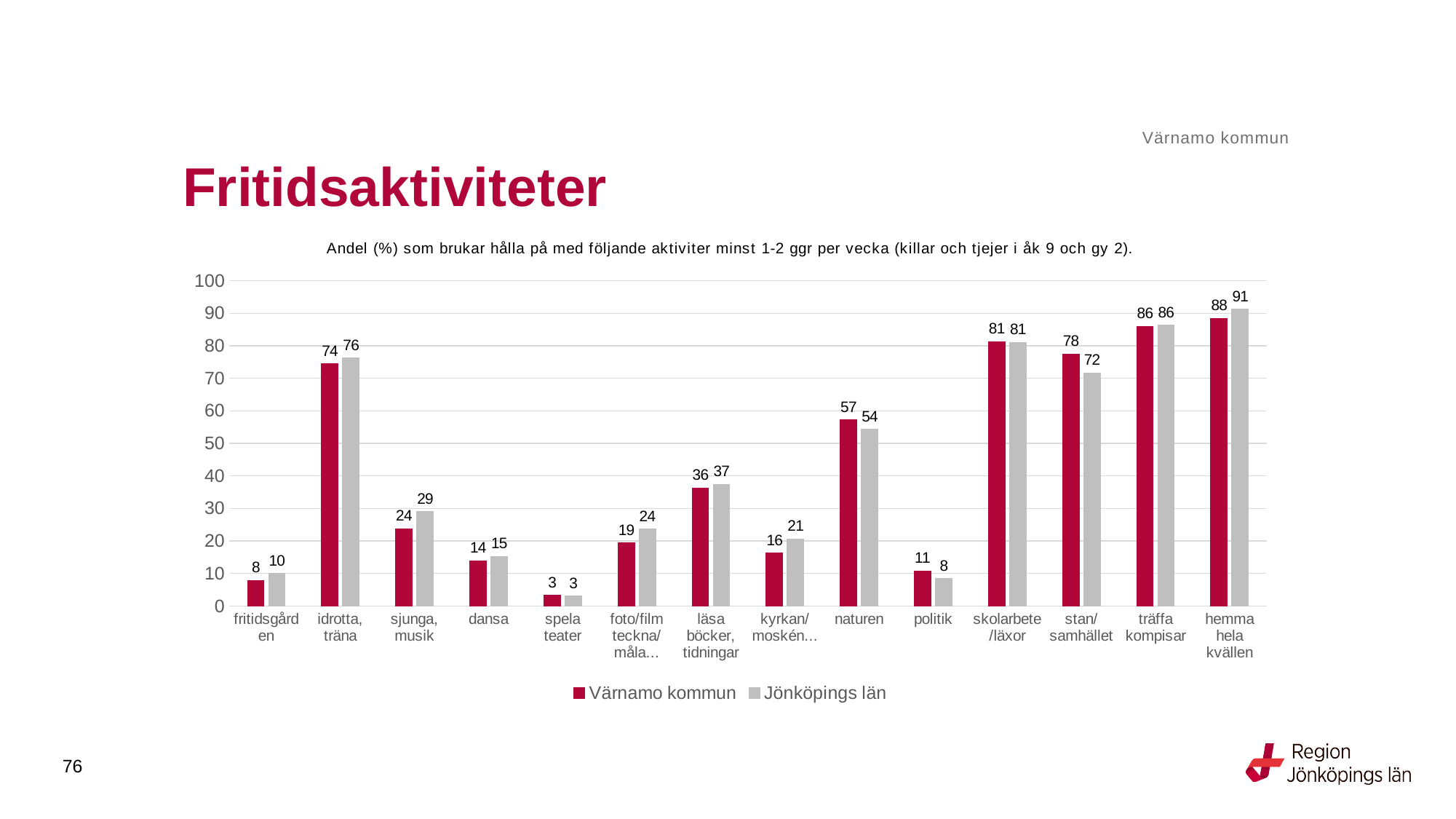
For 'politik', which series has the larger value, Värnamo kommun or Jönköpings län? Värnamo kommun What is the value for Värnamo kommun for 'träffa kompisar'? 86 What is the difference between Jönköpings län and Värnamo kommun for 'kyrkan/moskén…'? 5 Which category has the highest value for Jönköpings län? hemma hela kvällen How many categories are shown on the x axis? 14 Which series is shown in red in the legend? Värnamo kommun Which category has the lowest value for Värnamo kommun? spela teater What is the difference between Värnamo kommun and Jönköpings län for 'stan/samhället'? 6 What is the value for Värnamo kommun for 'naturen'? 57 What kind of chart is shown on the slide? bar chart What is the value for Jönköpings län for 'sjunga, musik'? 29 How many series does the legend list? 2